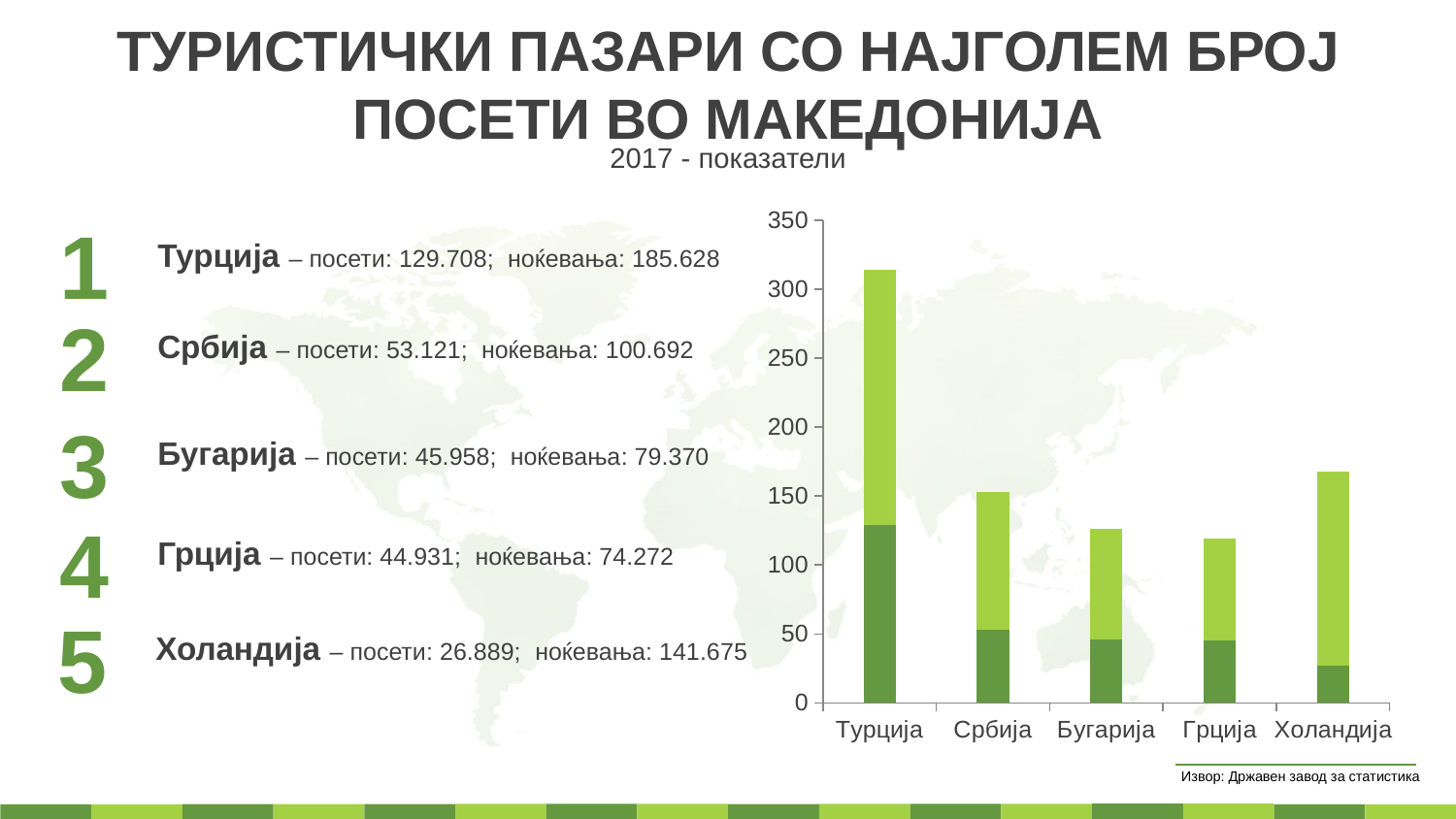
Is the total bar height for Бугарија greater or less than 150? less What kind of chart is shown on the slide? Stacked bar chart Is the total bar height for Турција greater or less than 300? greater Is the dark green segment for Турција greater or less than 100? greater Which bar is taller, Турција or Холандија? Турција Which country has the tallest bar in the chart? Турција Which bar is taller, Србија or Холандија? Холандија How many countries are shown on the x axis of the chart? 5 What is the highest value shown on the vertical axis of the chart? 350